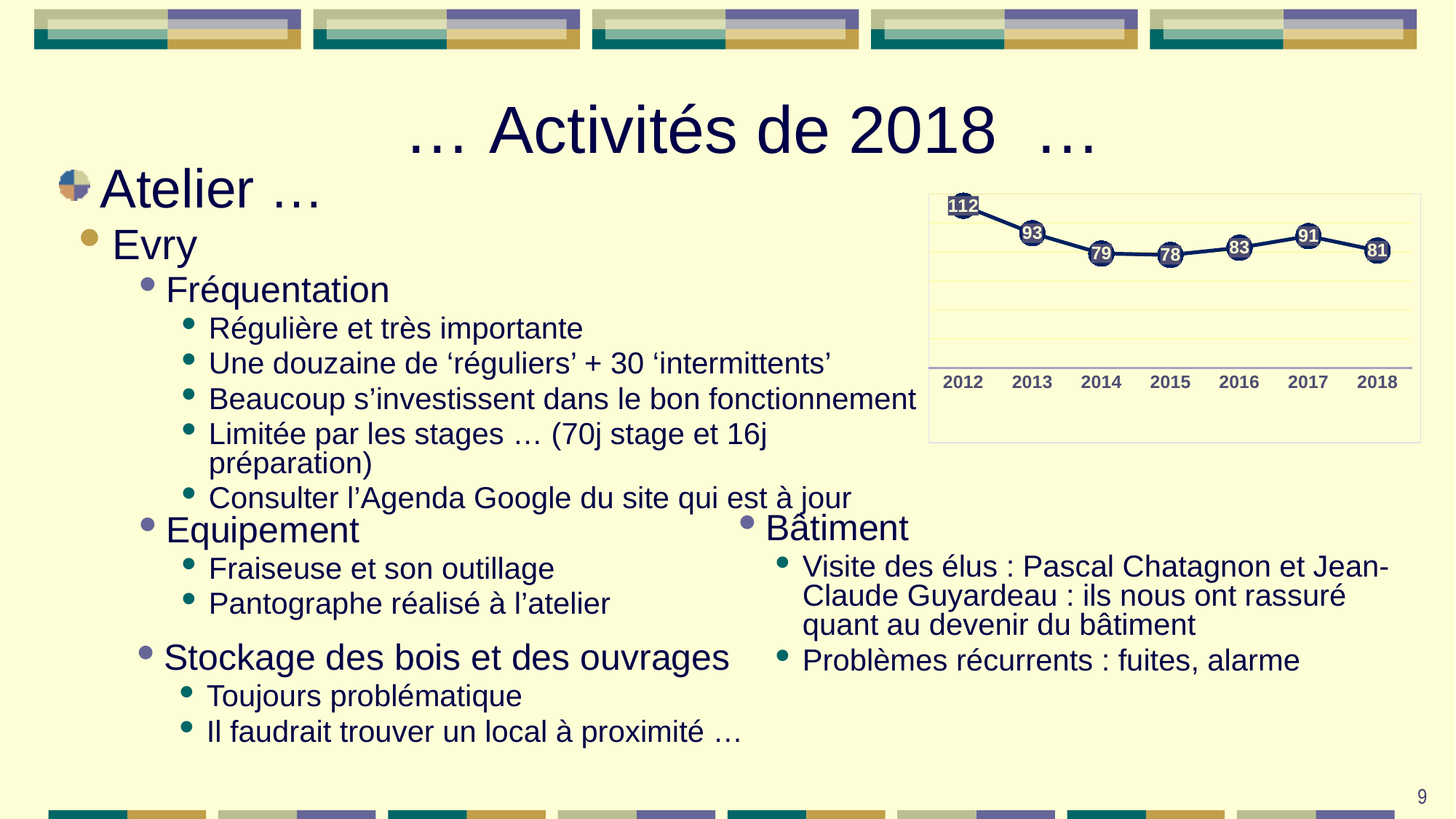
Which is larger, the value for 2016 or the value for 2017? 2017 Does the value rise or fall from 2012 to 2014? fall Which year has the highest value in the chart? 2012 What is the difference between the values for 2012 and 2013? 19 What is the value for 2018 in the chart? 81 What is the value for 2015 in the chart? 78 Which year has the lowest value in the chart? 2015 What is the value for 2012 in the chart? 112 What kind of chart is shown on the slide? line chart Does the value rise or fall from 2015 to 2017? rise What is the difference between the values for 2017 and 2018? 10 How many years are plotted on the x axis of the chart? 7